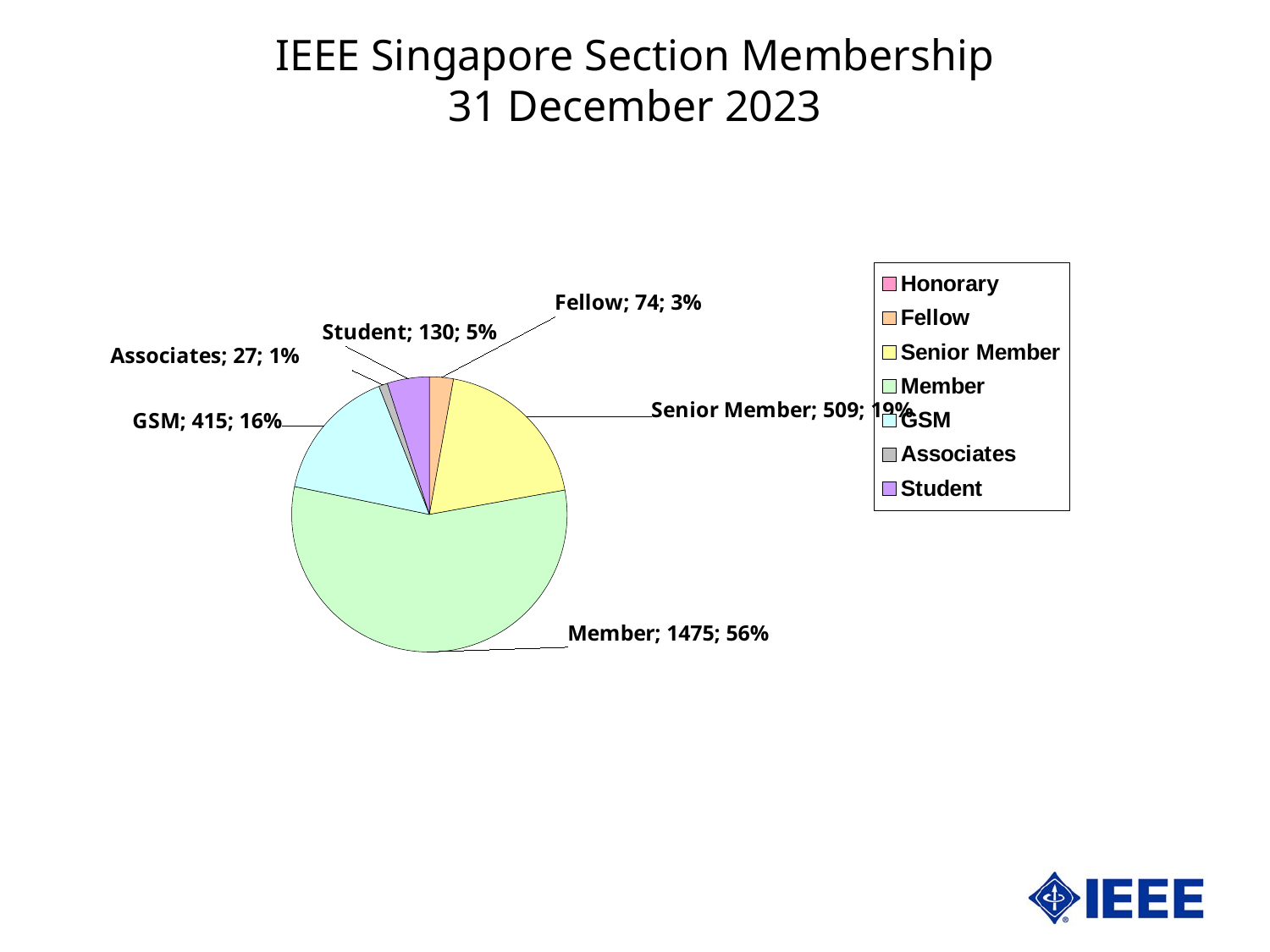
What kind of chart is shown on the slide? pie chart What percentage of the pie is the Student slice? 5% What is the title of the chart? IEEE Singapore Section Membership 31 December 2023 Which is larger, the Fellow count or the Student count? Student How many members are in the GSM category? 415 Which labelled category has the smallest slice of the pie? Associates What share of the pie does the Senior Member slice represent? 19% How many entries does the legend list? 7 Which category has the largest slice of the pie? Member What colour is the Member slice in the pie? light green How many members are in the Member category? 1475 What is the difference between the Senior Member count and the GSM count? 94